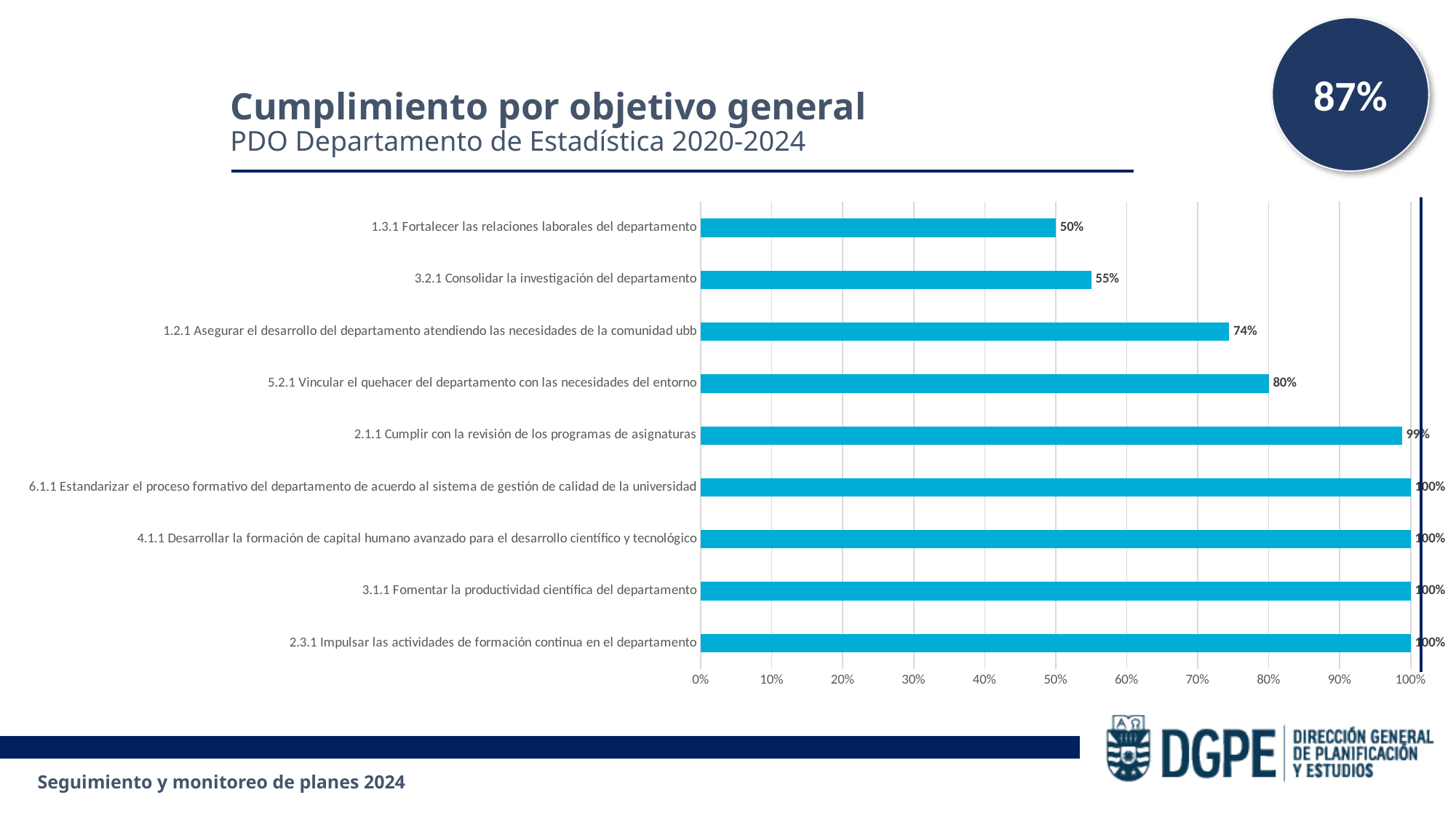
What is the value for 5.2.1 Vincular el quehacer del departamento con las necesidades del entorno? 80% What is the value for 1.3.1 Fortalecer las relaciones laborales del departamento? 50% Which category has the lowest value? 1.3.1 Fortalecer las relaciones laborales del departamento Which is larger, the value for 3.2.1 Consolidar la investigación del departamento or the value for 1.2.1 Asegurar el desarrollo del departamento atendiendo las necesidades de la comunidad ubb? 1.2.1 Asegurar el desarrollo del departamento atendiendo las necesidades de la comunidad ubb What is the value for 2.1.1 Cumplir con la revisión de los programas de asignaturas? 99% What is the value for 3.2.1 Consolidar la investigación del departamento? 55% What is the value for 1.2.1 Asegurar el desarrollo del departamento atendiendo las necesidades de la comunidad ubb? 74% What is the title of the slide? Cumplimiento por objetivo general How many categories have a value of 100%? 4 What is the difference between the values for 5.2.1 Vincular el quehacer del departamento con las necesidades del entorno and 1.3.1 Fortalecer las relaciones laborales del departamento? 30% What kind of chart is shown on the slide? Bar chart How many categories are shown in the chart? 9